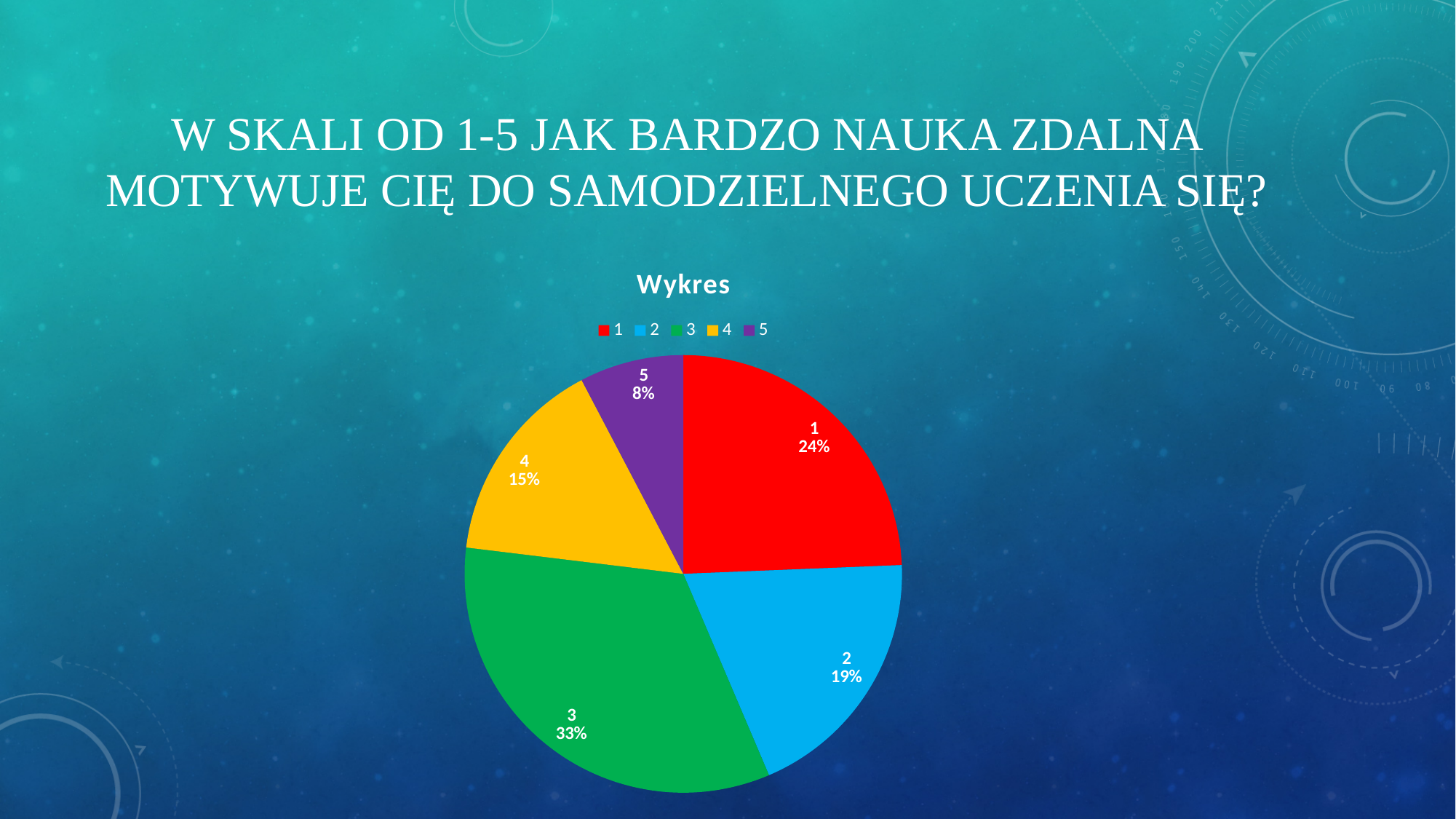
What share of the pie does category 1 have? 24% What kind of chart is shown on the slide? pie chart How many slices does the pie chart have? 5 What share of the pie does category 3 have? 33% What is the chart's title? Wykres Which category has the smallest slice? 5 What share of the pie does category 5 have? 8% What is the difference between the shares of category 1 and category 2? 5% Which is larger, the share for category 2 or the share for category 4? 2 How many entries does the legend list? 5 Which category has the largest slice? 3